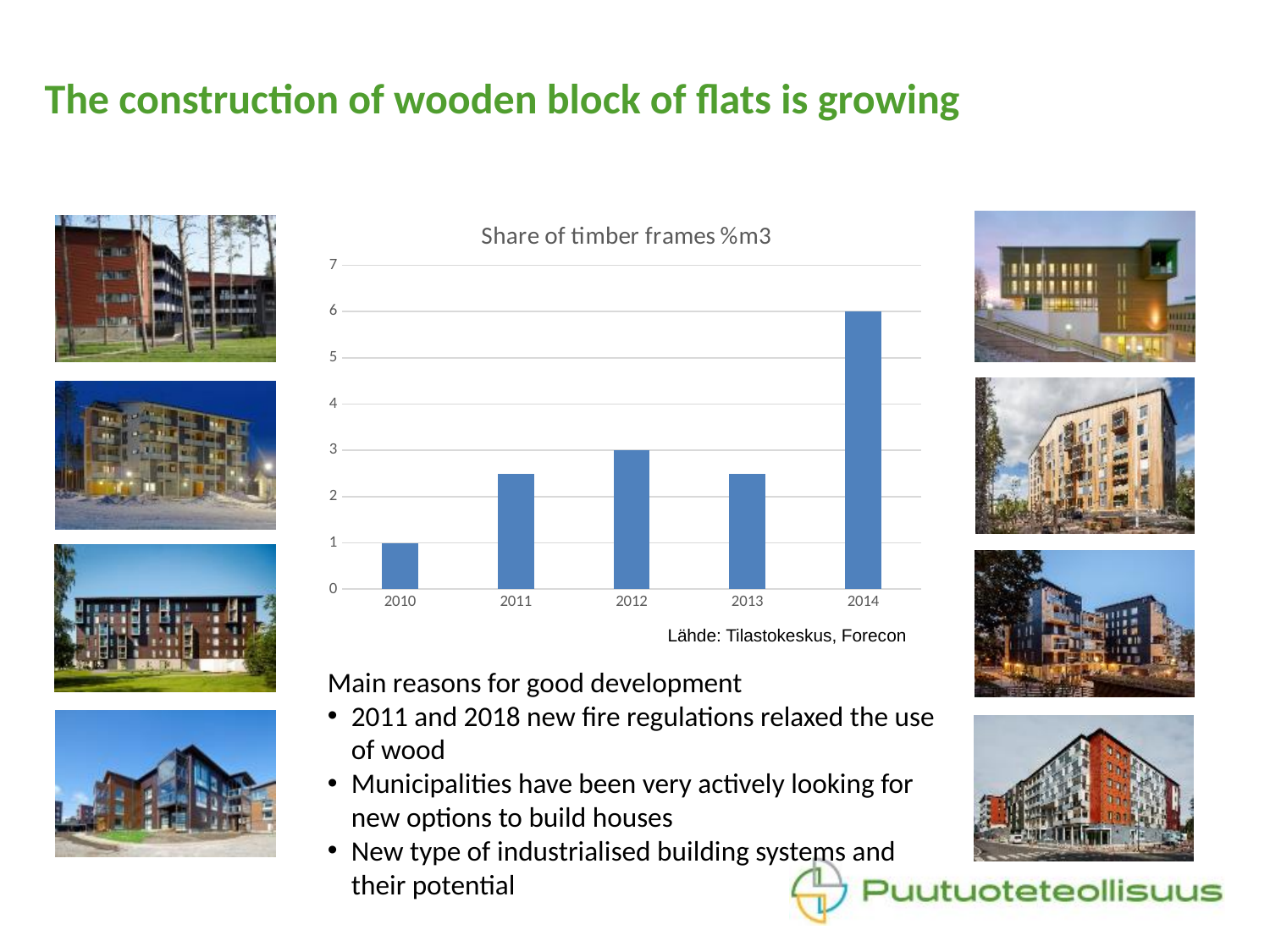
What is the difference between the share of timber frames in 2014 and in 2010? 5 What is the share of timber frames for 2014? 6 Which year has the lowest share of timber frames? 2010 How many years are shown on the x axis of the chart? 5 Which year has a larger share of timber frames, 2012 or 2010? 2012 What kind of chart is shown on the slide? Bar chart Is the value for 2013 greater or less than 3? less What is the share of timber frames for 2012? 3 What is the share of timber frames for 2010? 1 Which year has the highest share of timber frames? 2014 What is the title of the chart? Share of timber frames %m3 Is the value for 2011 greater or less than 2? greater